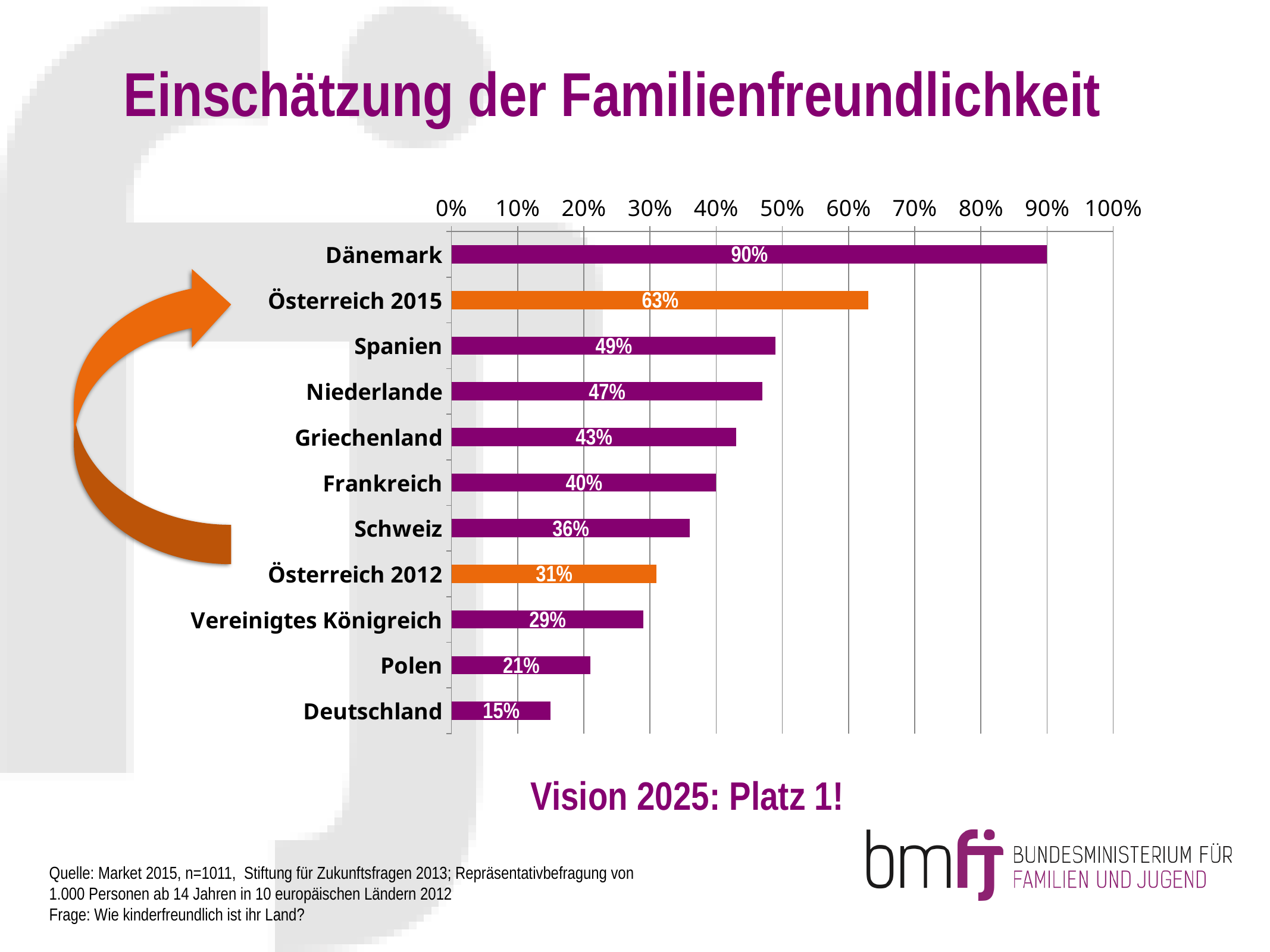
What is the value for Österreich 2015? 63% Which category has the highest value? Dänemark Which is larger, the value for Spanien or the value for Niederlande? Spanien Which bars are coloured orange instead of purple? Österreich 2015 and Österreich 2012 How many categories are shown in the chart? 11 What is the value for Dänemark? 90% What is the difference between the values for Dänemark and Deutschland? 75% What is the value for Schweiz? 36% What is the value for Deutschland? 15% Which category has the lowest value? Deutschland What is the difference between the values for Österreich 2015 and Österreich 2012? 32% What kind of chart is shown on the slide? Bar chart